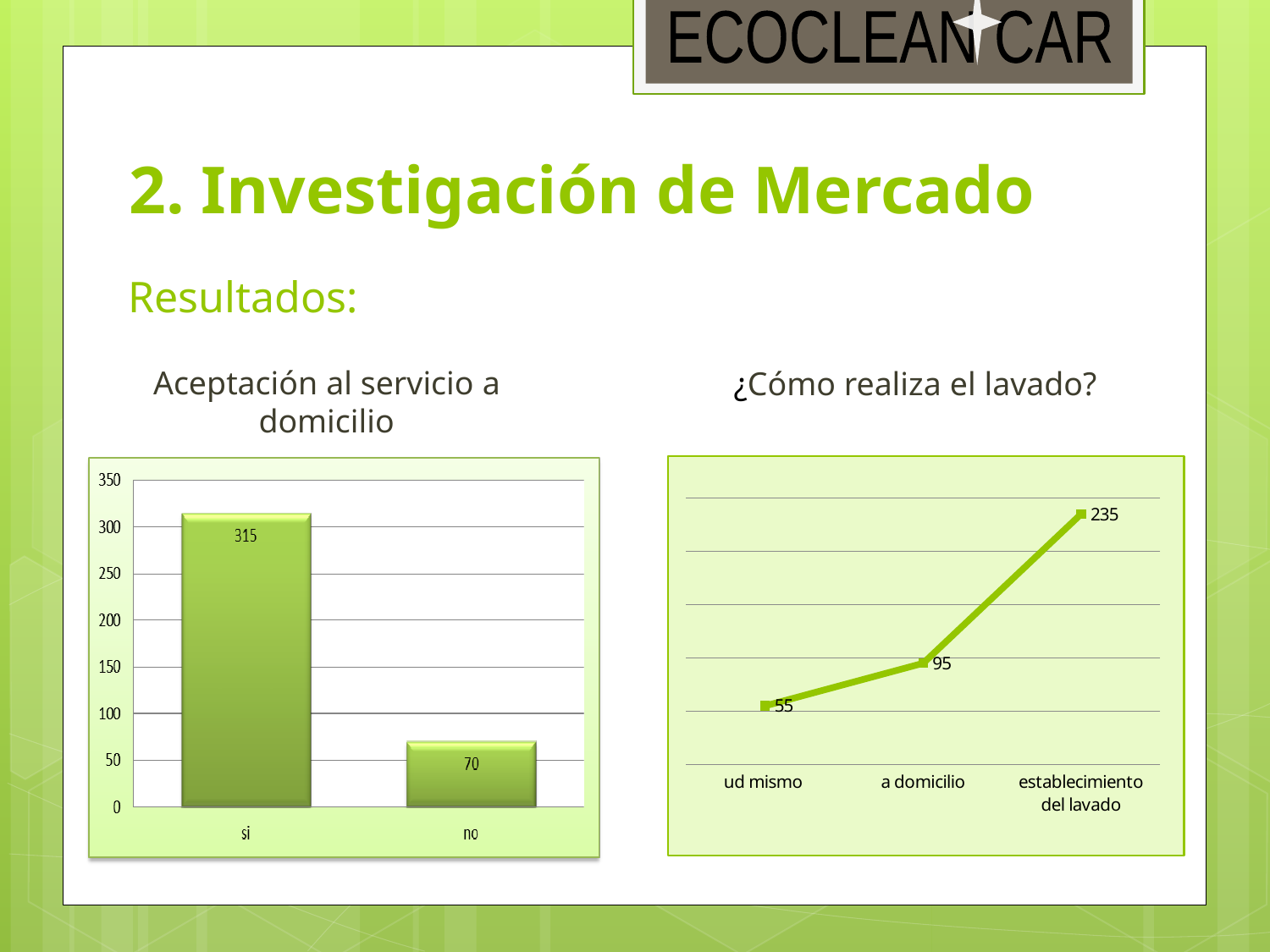
In the 'Aceptación al servicio a domicilio' chart, what is the difference between the values for 'si' and 'no'? 245 In the '¿Cómo realiza el lavado?' chart, do the values rise or fall from left to right along the x axis? rise In the '¿Cómo realiza el lavado?' chart, what is the value for 'establecimiento del lavado'? 235 How many categories are shown in the 'Aceptación al servicio a domicilio' chart? 2 What kind of chart is the 'Aceptación al servicio a domicilio' chart? bar chart In the '¿Cómo realiza el lavado?' chart, what is the value for 'a domicilio'? 95 In the 'Aceptación al servicio a domicilio' chart, what is the value for 'si'? 315 In the 'Aceptación al servicio a domicilio' chart, what is the value for 'no'? 70 In the '¿Cómo realiza el lavado?' chart, what is the difference between the values for 'establecimiento del lavado' and 'ud mismo'? 180 In the '¿Cómo realiza el lavado?' chart, which category has the lowest value? ud mismo In the 'Aceptación al servicio a domicilio' chart, which category has the higher value? si What kind of chart is the '¿Cómo realiza el lavado?' chart? line chart